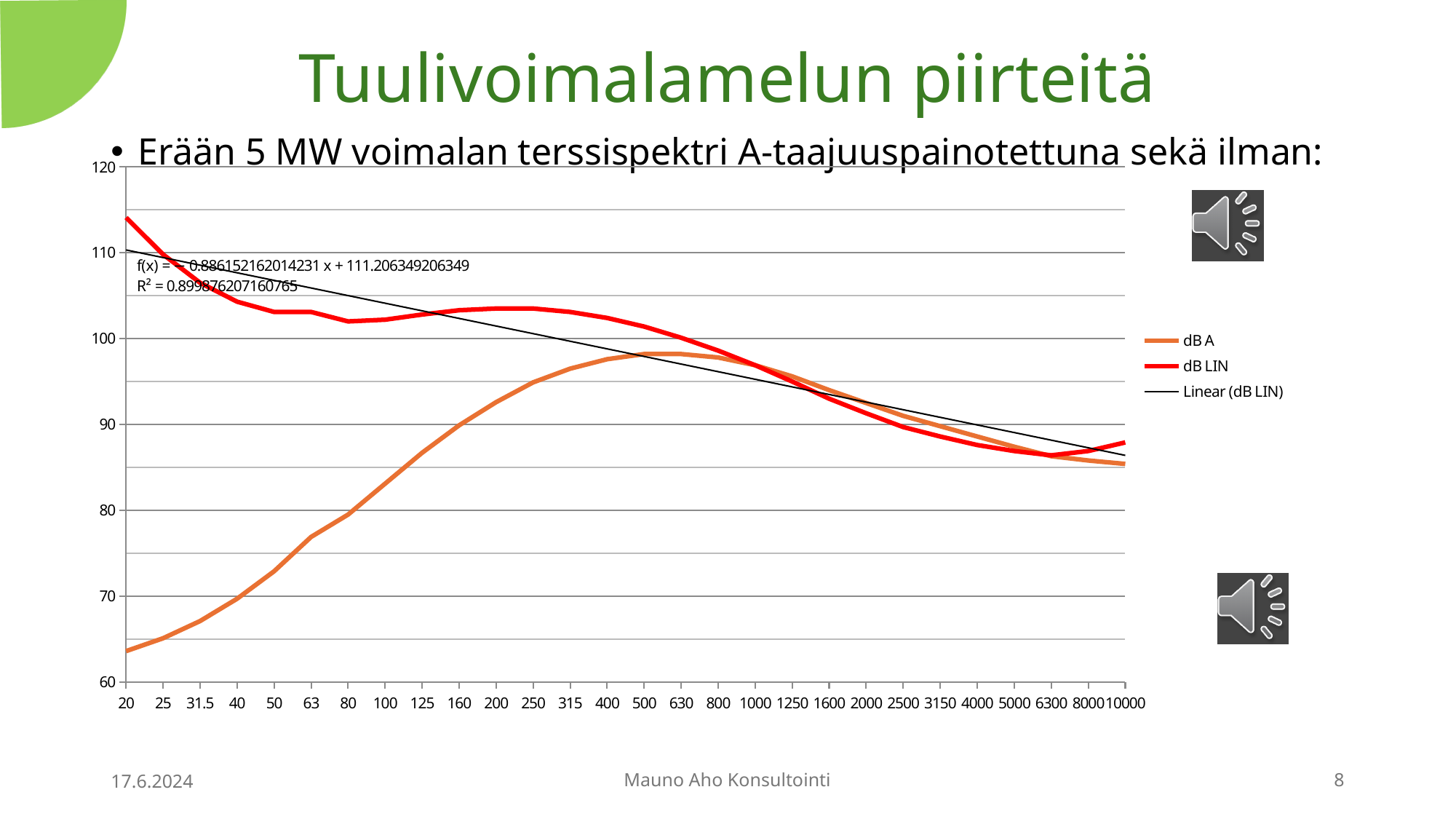
Is the dB A value at 63 greater or less than 80? less At which frequency is the dB LIN series at its highest? 20 Is the dB LIN value at 250 greater or less than 100? greater Is the dB A value at 20 greater or less than 70? less How many frequency categories are shown on the x axis? 28 At 20 Hz, which series has the larger value, dB A or dB LIN? dB LIN What R² value is printed on the chart for the linear trendline? 0.899876207160765 How many entries does the chart legend list? 3 What kind of chart is shown on the slide? line chart At which frequency is the dB A series at its lowest? 20